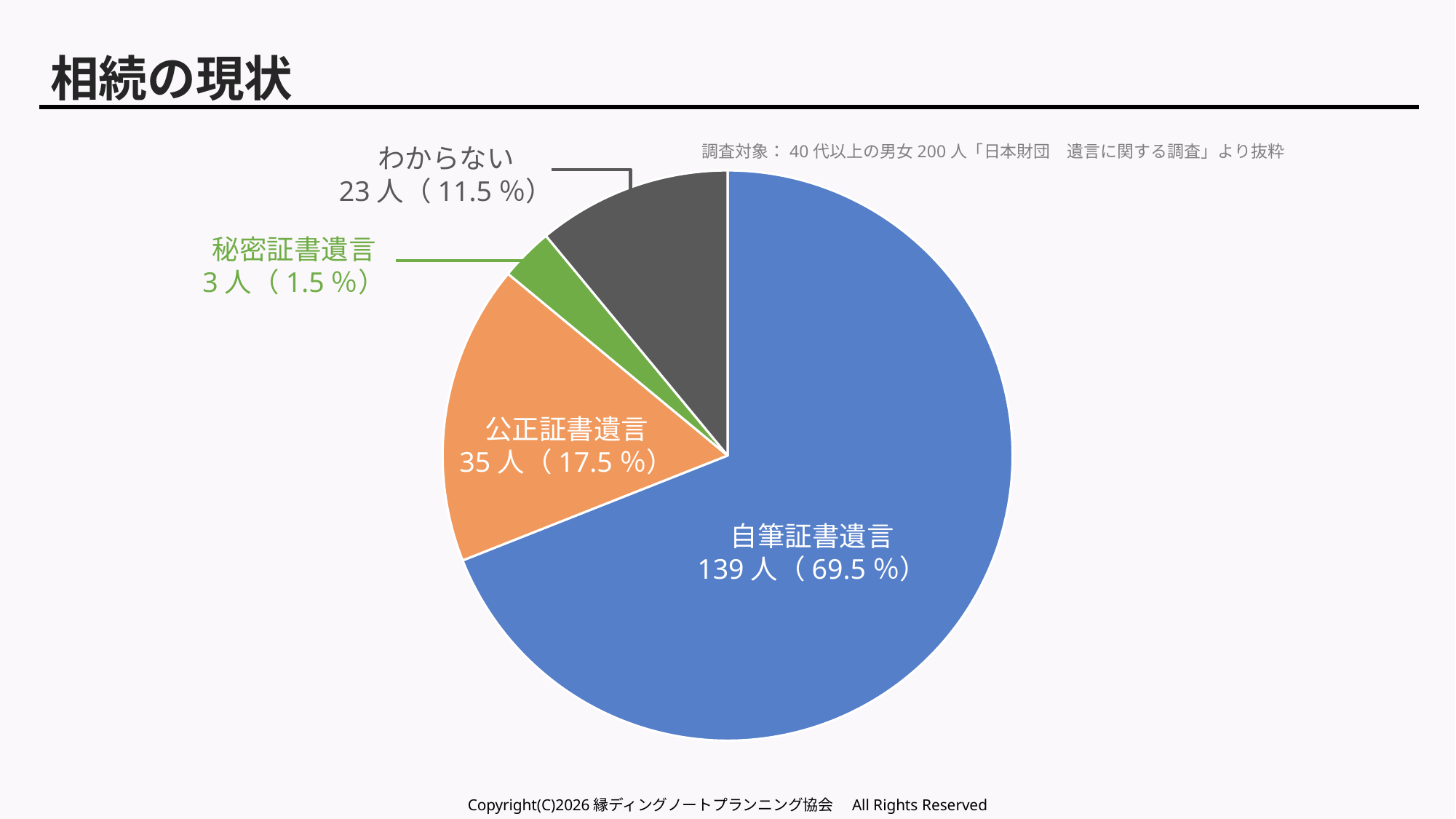
Which category has the largest slice in the pie chart? 自筆証書遺言 How many people chose 自筆証書遺言 in the pie chart? 139 人 What is the total number of people across all slices of the pie chart? 200 人 What colour is the slice for 公正証書遺言? orange How many categories (slices) does the pie chart have? 4 What percentage of the pie does 公正証書遺言 represent? 17.5 % What is the difference in number of people between 自筆証書遺言 and 公正証書遺言? 104 人 How many people answered わからない? 23 人 Which category has the smallest slice in the pie chart? 秘密証書遺言 What kind of chart is shown on the slide? pie chart What share of the pie does 秘密証書遺言 account for? 1.5 % Which has more respondents, 公正証書遺言 or わからない? 公正証書遺言